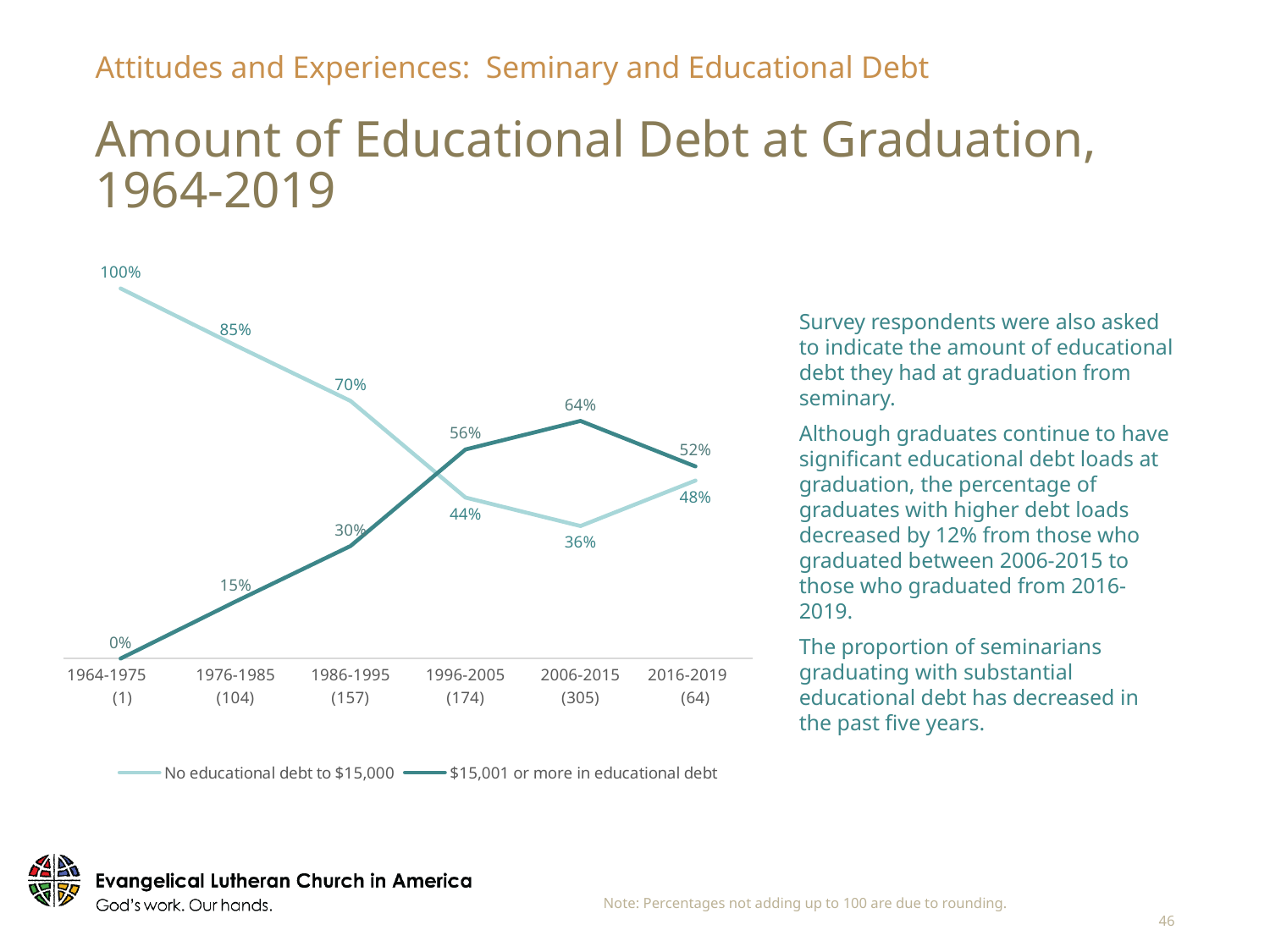
In which period is the value for "No educational debt to $15,000" lowest? 2006-2015 Which series has the larger value in 1996-2005? $15,001 or more in educational debt What is the difference between the two series in 2016-2019? 4% How many respondents are indicated for the 2006-2015 period? 305 What type of chart is shown on the slide? Line chart What is the value for "$15,001 or more in educational debt" in 1986-1995? 30% What is the value for "No educational debt to $15,000" in 1976-1985? 85% How many time periods are shown on the x axis? 6 Does the value for "No educational debt to $15,000" rise or fall from 1964-1975 to 2006-2015? Fall How many series does the legend list? 2 What is the value for "$15,001 or more in educational debt" in 2006-2015? 64% In which period is the value for "$15,001 or more in educational debt" highest? 2006-2015